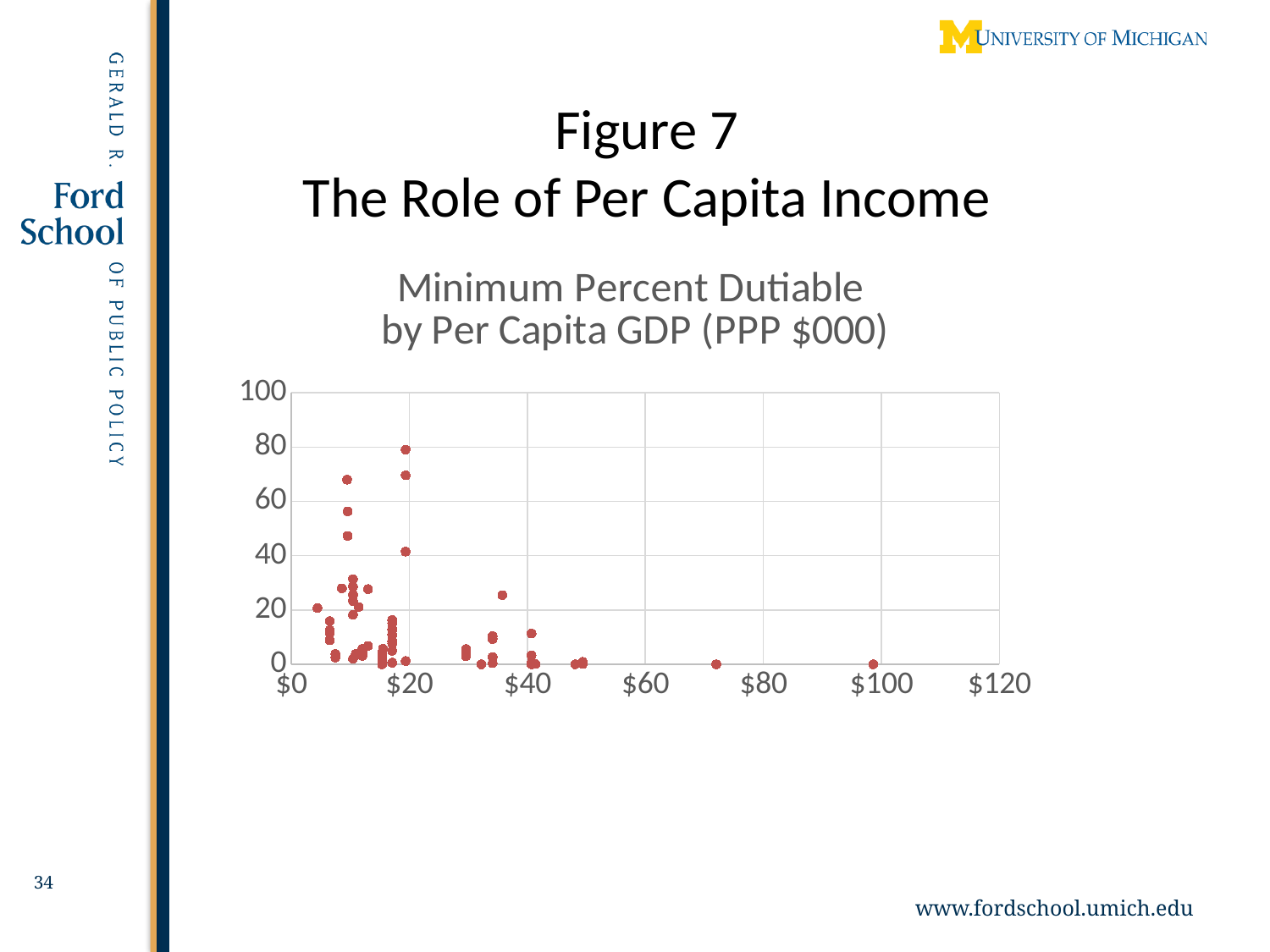
Is the minimum percent dutiable for the point near $72 per capita GDP greater or less than 20? less What is the interval between consecutive tick labels on the vertical axis? 20 Is the minimum percent dutiable for the point near $35 per capita GDP greater or less than 40? less What kind of chart is shown on the slide? scatter chart Is the minimum percent dutiable for the point with the highest per capita GDP (near $100) greater or less than 20? less Do the minimum percent dutiable values generally rise or fall as per capita GDP increases along the x axis? fall What is the highest value labelled on the vertical axis of the chart? 100 What is the highest value labelled on the horizontal axis of the chart? $120 What is the title of the chart? Minimum Percent Dutiable by Per Capita GDP (PPP $000)